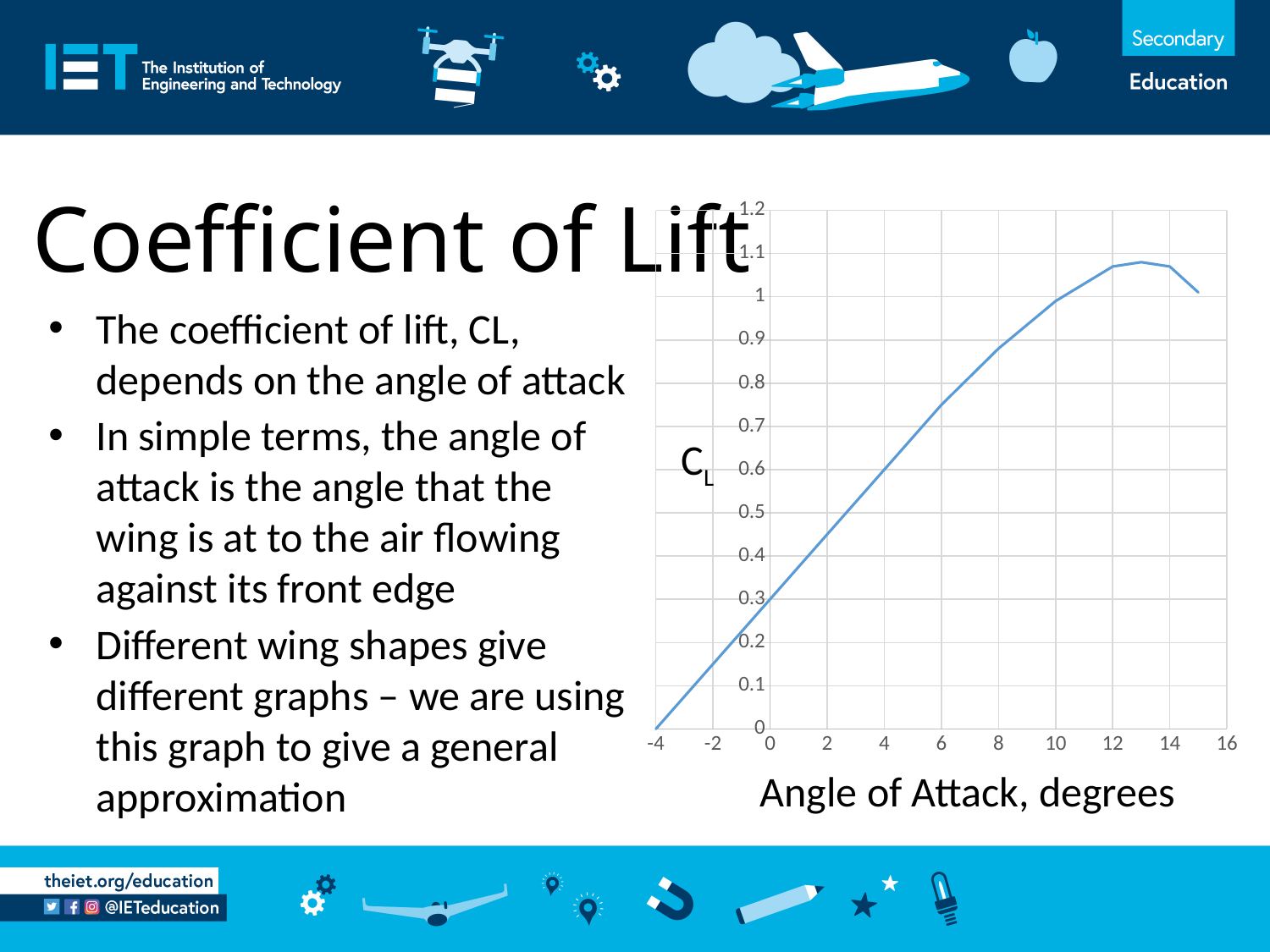
Is the coefficient of lift at 15 degrees greater or less than 1.1? less Does the coefficient of lift rise or fall as the angle of attack increases from 14 to 15 degrees? fall What kind of chart is shown on the slide? line chart Does the coefficient of lift rise or fall as the angle of attack increases from -4 to 10 degrees? rise Is the coefficient of lift at 12 degrees greater or less than 1? greater Is the coefficient of lift at 8 degrees greater or less than 0.8? greater What is the coefficient of lift at an angle of attack of -4 degrees? 0 Which angle of attack gives a larger coefficient of lift, 4 degrees or 8 degrees? 8 degrees What is the label of the x axis of the chart? Angle of Attack, degrees